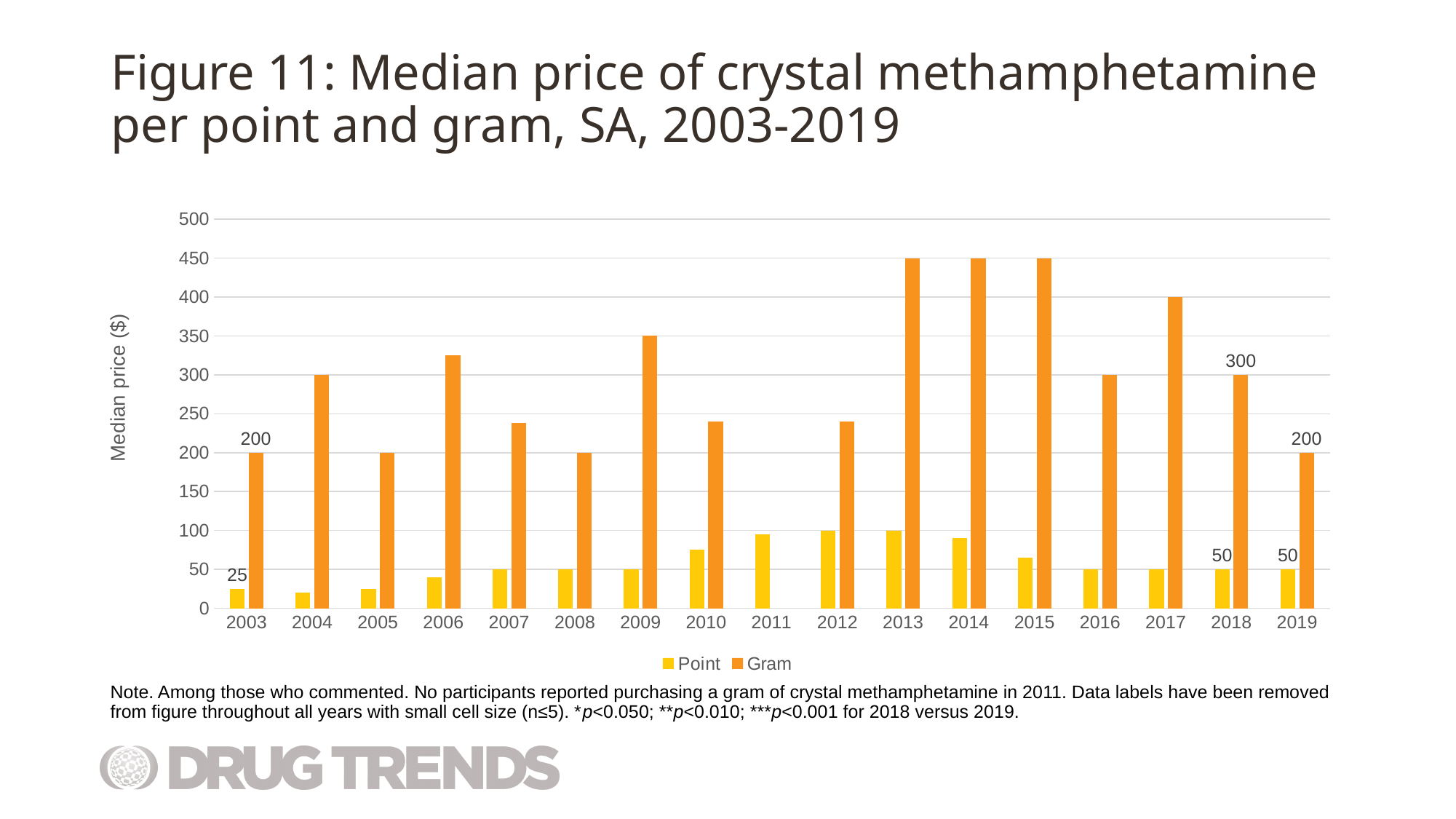
Which year has the higher median price per gram, 2018 or 2019? 2018 What is the median price per point in 2019? 50 What is the median price per point in 2003? 25 What kind of chart is shown on the slide? Bar chart How many years are shown on the x axis? 17 What is the difference between the median price per point in 2019 and in 2003? 25 What is the median price per gram in 2018? 300 Is the median price per point in 2011 greater or less than 50? greater What is the median price per gram in 2019? 200 What is the difference between the median price per gram in 2018 and in 2019? 100 How many series does the legend list? 2 Is the median price per gram in 2013 greater or less than 400? greater